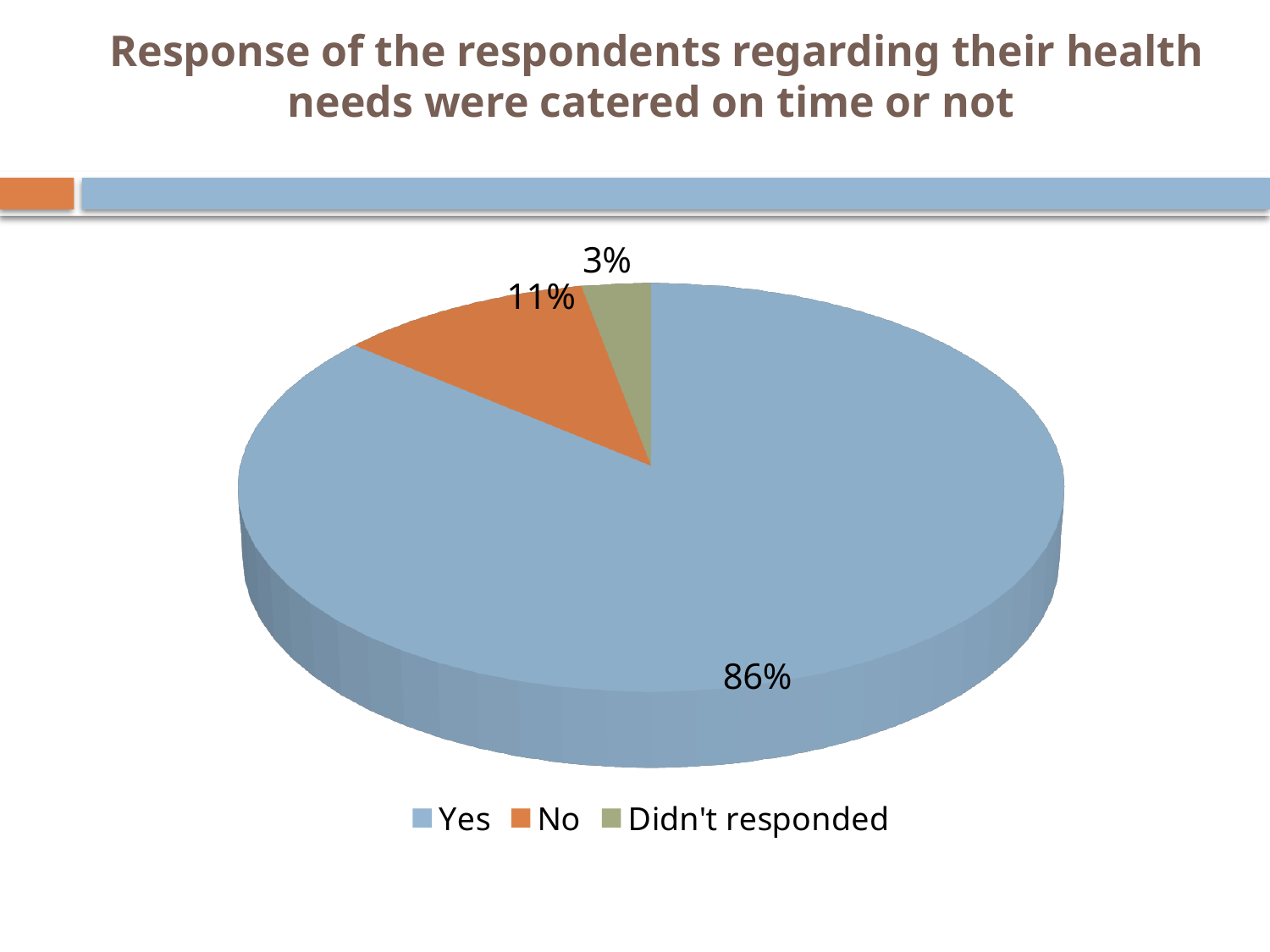
How many categories are shown in the pie chart? 3 What is the difference in percentage points between the Yes and No slices? 75 Which is larger, the share for No or the share for Didn't responded? No Which response category has the smallest share of the pie? Didn't responded What is the difference in percentage points between the No slice and the Didn't responded slice? 8 What kind of chart is shown on the slide? Pie chart What percentage of respondents didn't respond? 3% What is the title of the chart? Response of the respondents regarding their health needs were catered on time or not What percentage of respondents answered No? 11% What percentage of respondents answered Yes? 86% What colour is the slice representing No? Orange Which response category has the largest share of the pie? Yes